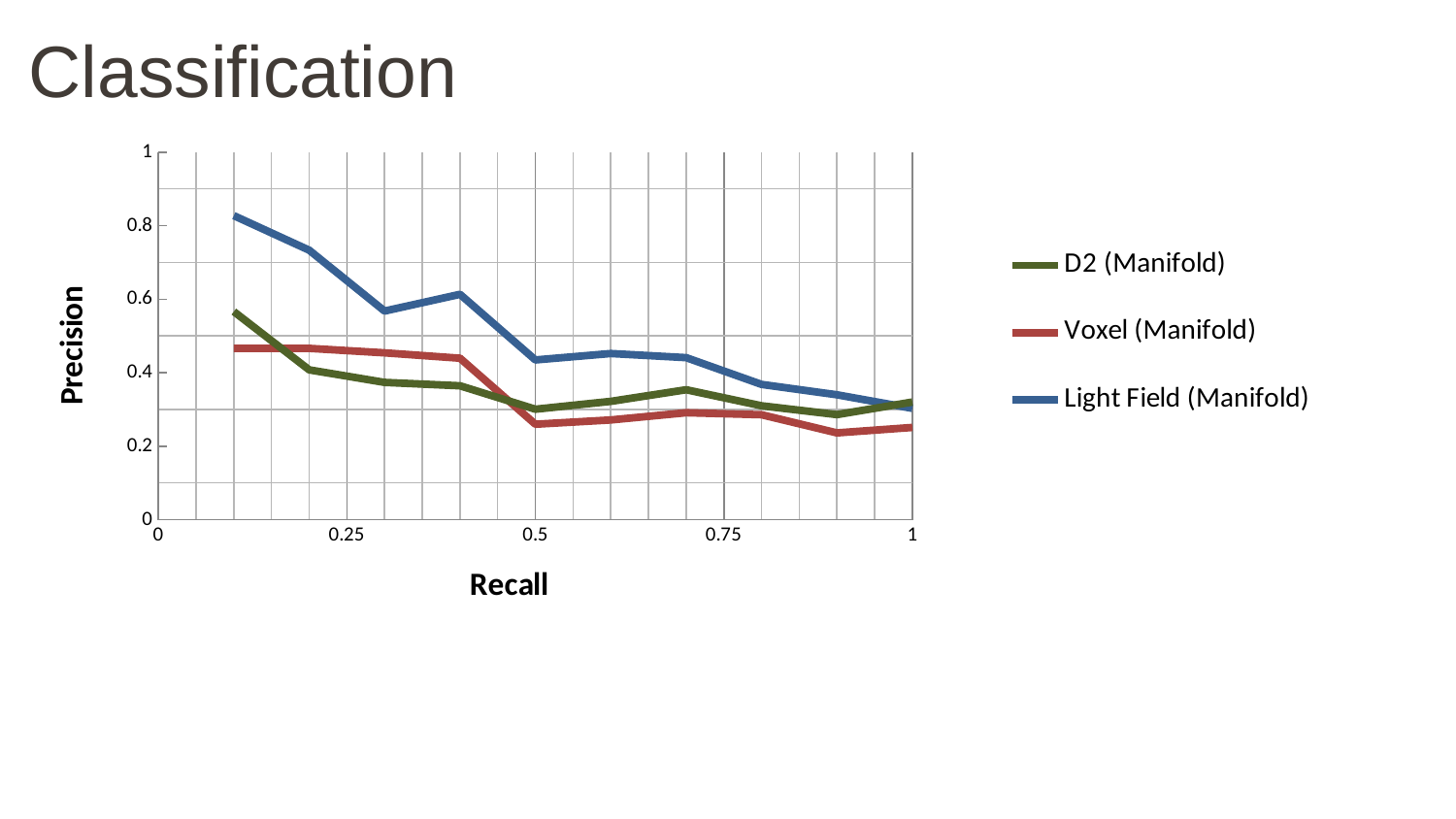
Is the precision of Voxel (Manifold) at recall 0.5 greater or less than 0.4? less At recall 0.3, which has higher precision: Light Field (Manifold) or Voxel (Manifold)? Light Field (Manifold) What kind of chart is shown on the slide? line chart How many data points does each series have? 10 How many series does the legend list? 3 Which series has the lowest precision at recall 0.9? Voxel (Manifold) Is the precision of D2 (Manifold) at recall 0.1 greater or less than 0.4? greater What is the title of the y axis? Precision Which series has the highest precision at recall 0.1? Light Field (Manifold) Does the precision of Light Field (Manifold) generally rise or fall as recall increases? fall Is the precision of Light Field (Manifold) at recall 0.1 greater or less than 0.6? greater What is the title of the x axis? Recall